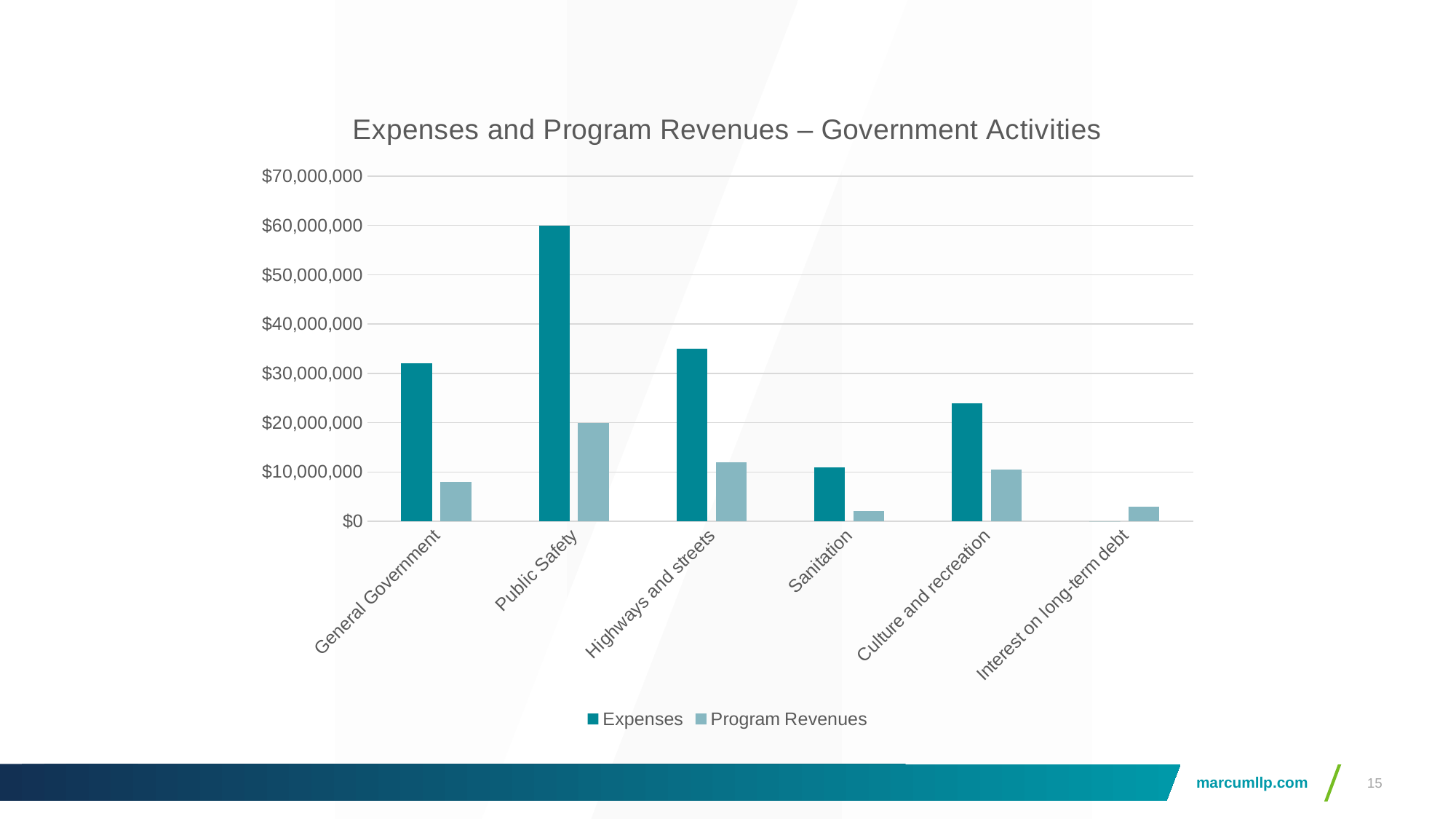
How many categories are shown on the x axis? 6 Which category has the highest Expenses? Public Safety Is the Expenses value for General Government greater or less than $30,000,000? greater Which category has the lowest Expenses? Interest on long-term debt What is the difference between Expenses and Program Revenues for Public Safety? $40,000,000 Which category has the highest Program Revenues? Public Safety What type of chart is shown on the slide? Bar chart What is the Expenses value for Public Safety? $60,000,000 For Highways and streets, which is larger: Expenses or Program Revenues? Expenses What is the Program Revenues value for Public Safety? $20,000,000 What is the title of the chart? Expenses and Program Revenues – Government Activities How many series does the legend list? 2